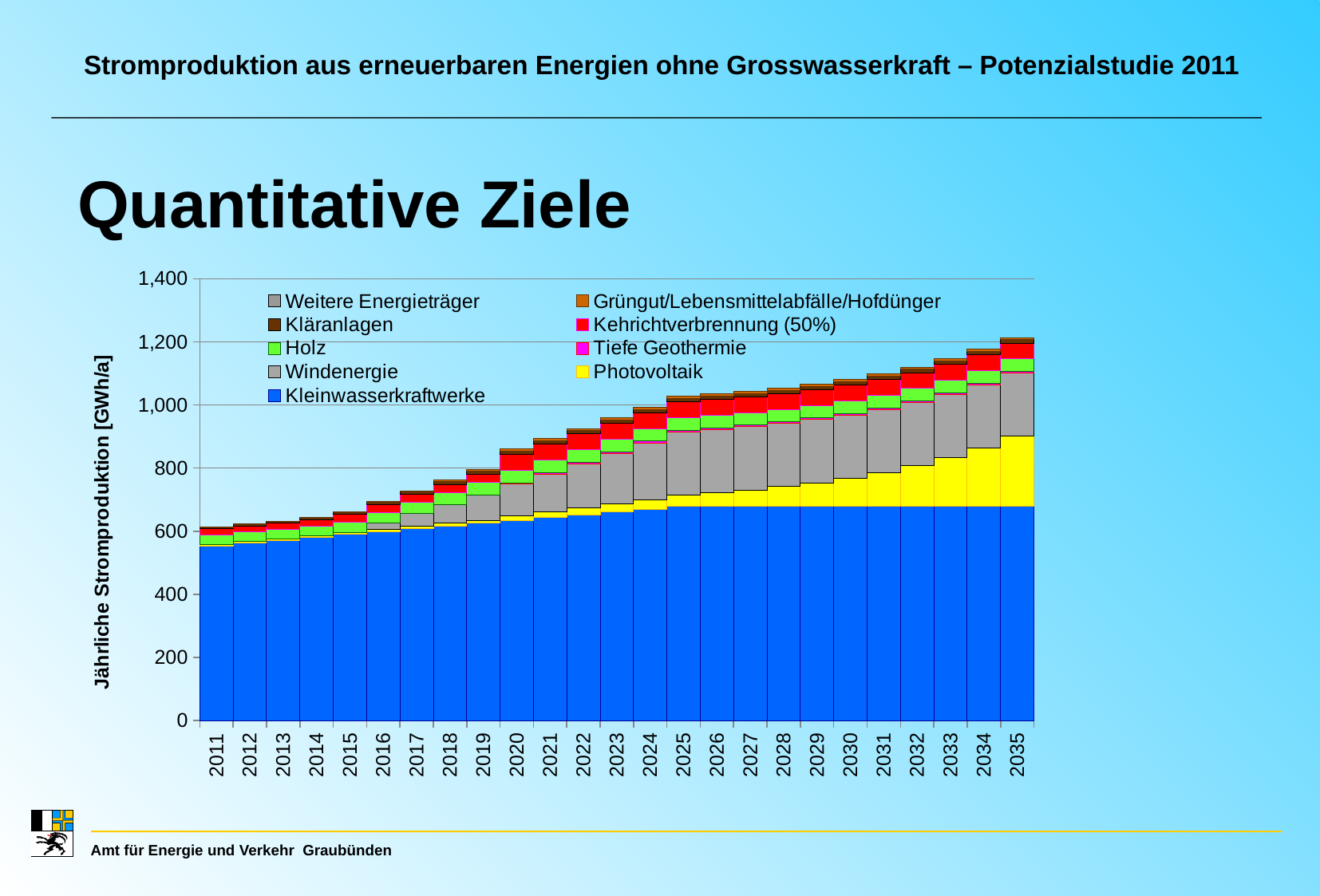
Is the total value for 2030 greater or less than 1,000? greater Do the total values rise or fall from 2011 to 2035? rise Is the total value for 2011 greater or less than 800? less What kind of chart is shown on the slide? stacked bar chart Is the total value for 2035 greater or less than 1,000? greater How many series does the legend list? 9 Which series is shown in blue at the bottom of each stacked bar? Kleinwasserkraftwerke Which year has the highest total annual electricity production? 2035 How many years are shown along the x axis? 25 Which year has the lowest total annual electricity production? 2011 What is the label of the y axis? Jährliche Stromproduktion [GWh/a]